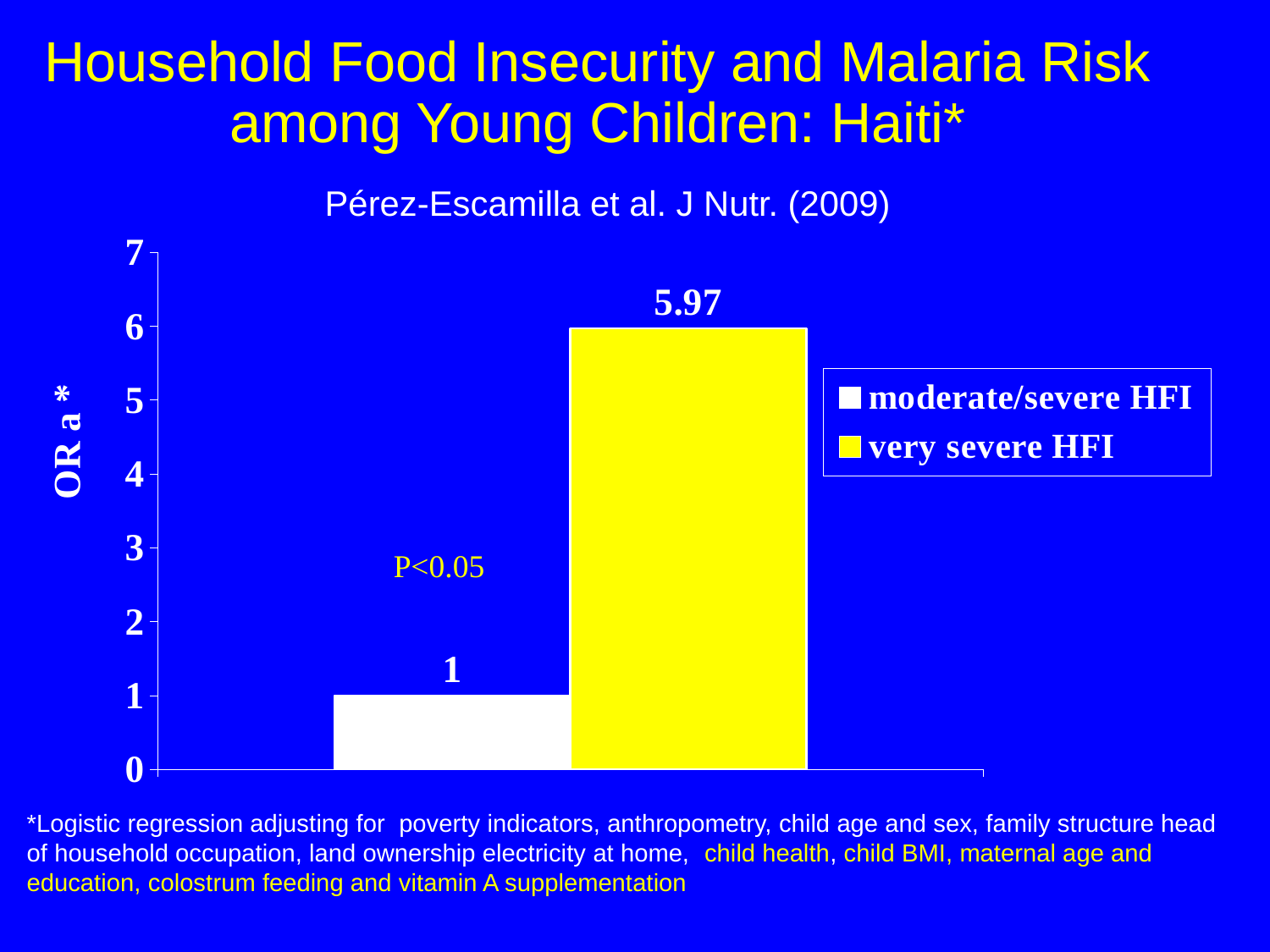
How many series does the legend list? 2 Which series has the lower odds ratio? moderate/severe HFI What is the odds ratio (OR) for very severe HFI? 5.97 What is the odds ratio (OR) for moderate/severe HFI? 1 How many bars are plotted in the chart? 2 What is the label on the y axis of the chart? OR a * What colour is the bar for very severe HFI? yellow Is the odds ratio for moderate/severe HFI greater or less than 2? less Which series has the higher odds ratio, moderate/severe HFI or very severe HFI? very severe HFI What is the difference between the odds ratio for very severe HFI and moderate/severe HFI? 4.97 What kind of chart is shown on the slide? bar chart Is the odds ratio for very severe HFI greater or less than 5? greater